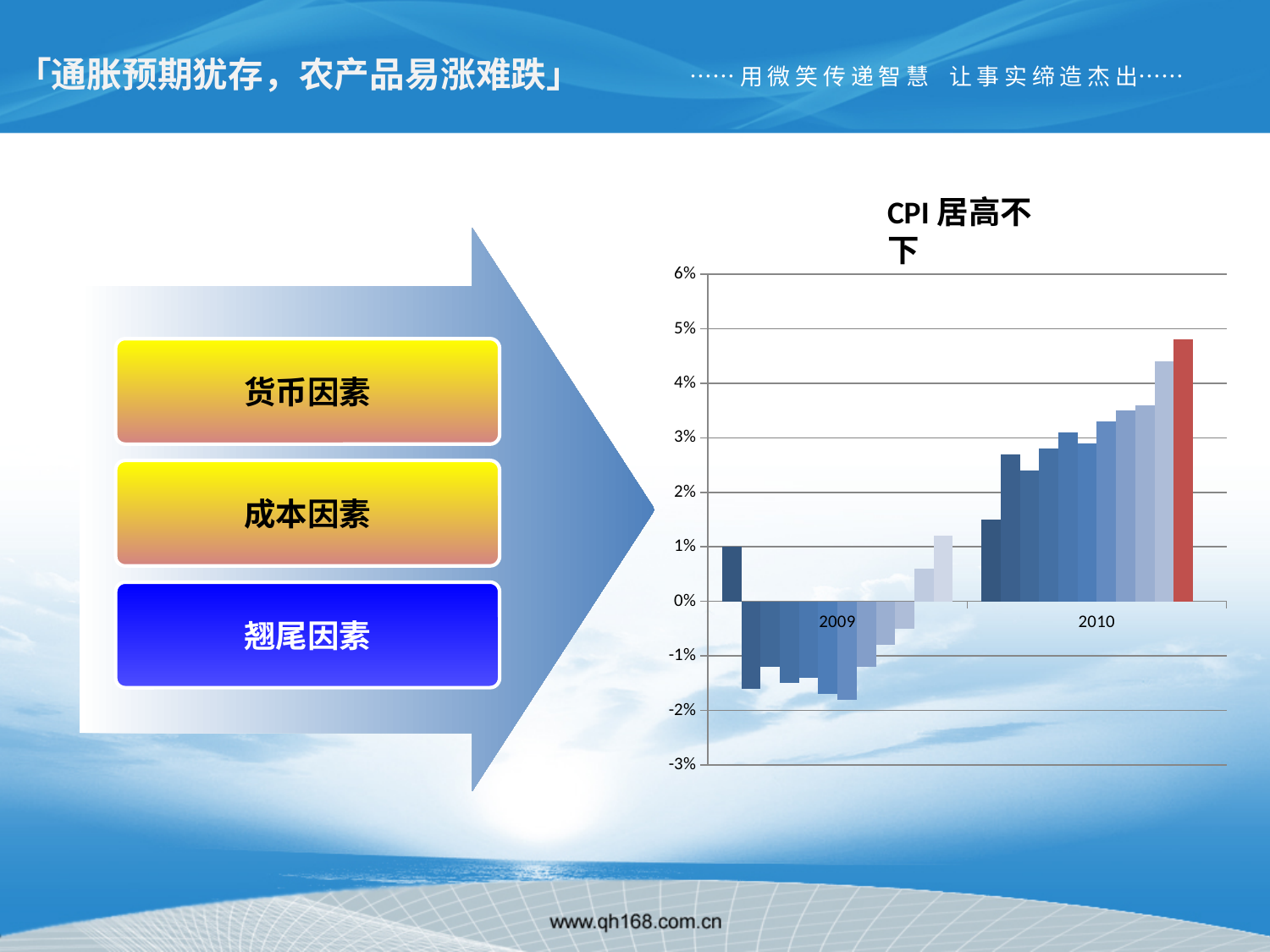
In the CPI chart, which year contains the highest bar? 2010 What is the highest value shown on the y axis of the CPI chart? 6% In the CPI chart, is the value of the first bar in 2009 greater or less than 0%? greater How many year labels appear on the x axis of the CPI chart? 2 In the CPI chart, do the bars for 2010 generally rise or fall from left to right? rise In the CPI chart, is the lowest bar in 2009 greater or less than -1%? less In the CPI chart, is the value of the last (red) bar in 2010 greater or less than 4%? greater Which years are labelled on the x axis of the CPI chart? 2009 and 2010 In the CPI chart, which year contains the lowest bar? 2009 What kind of chart is shown on the right side of the slide? bar chart What is the title of the chart on the slide? CPI 居高不下